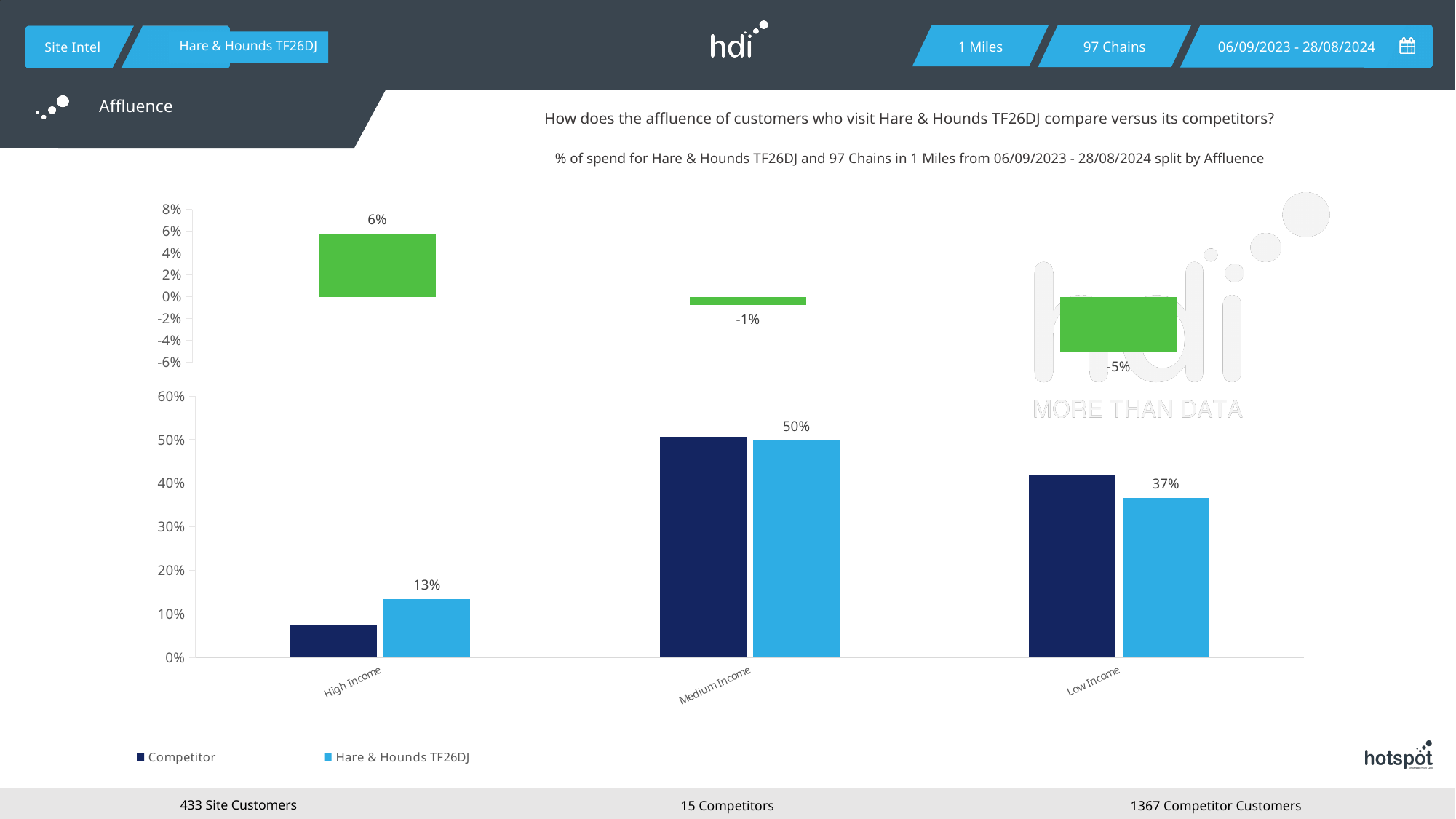
In the top difference chart, which category has the lowest value? Low Income In the bottom bar chart, is the Competitor value for High Income greater or less than 10%? less In the bottom bar chart, which category has the highest value for Hare & Hounds TF26DJ? Medium Income In the top difference chart, what is the value shown for Low Income? -5% In the top difference chart, what is the value shown for High Income? 6% In the bottom bar chart, what is the value for Hare & Hounds TF26DJ in the Medium Income category? 50% In the bottom bar chart, what is the value for Hare & Hounds TF26DJ in the Low Income category? 37% In the bottom bar chart, which is larger for High Income: the Competitor value or the Hare & Hounds TF26DJ value? Hare & Hounds TF26DJ How many series does the legend of the bottom bar chart list? 2 In the bottom bar chart, what is the value for Hare & Hounds TF26DJ in the High Income category? 13% In the bottom bar chart, is the Competitor value for Low Income greater or less than 40%? greater In the bottom bar chart, what is the difference between the Hare & Hounds TF26DJ values for Medium Income and Low Income? 13%